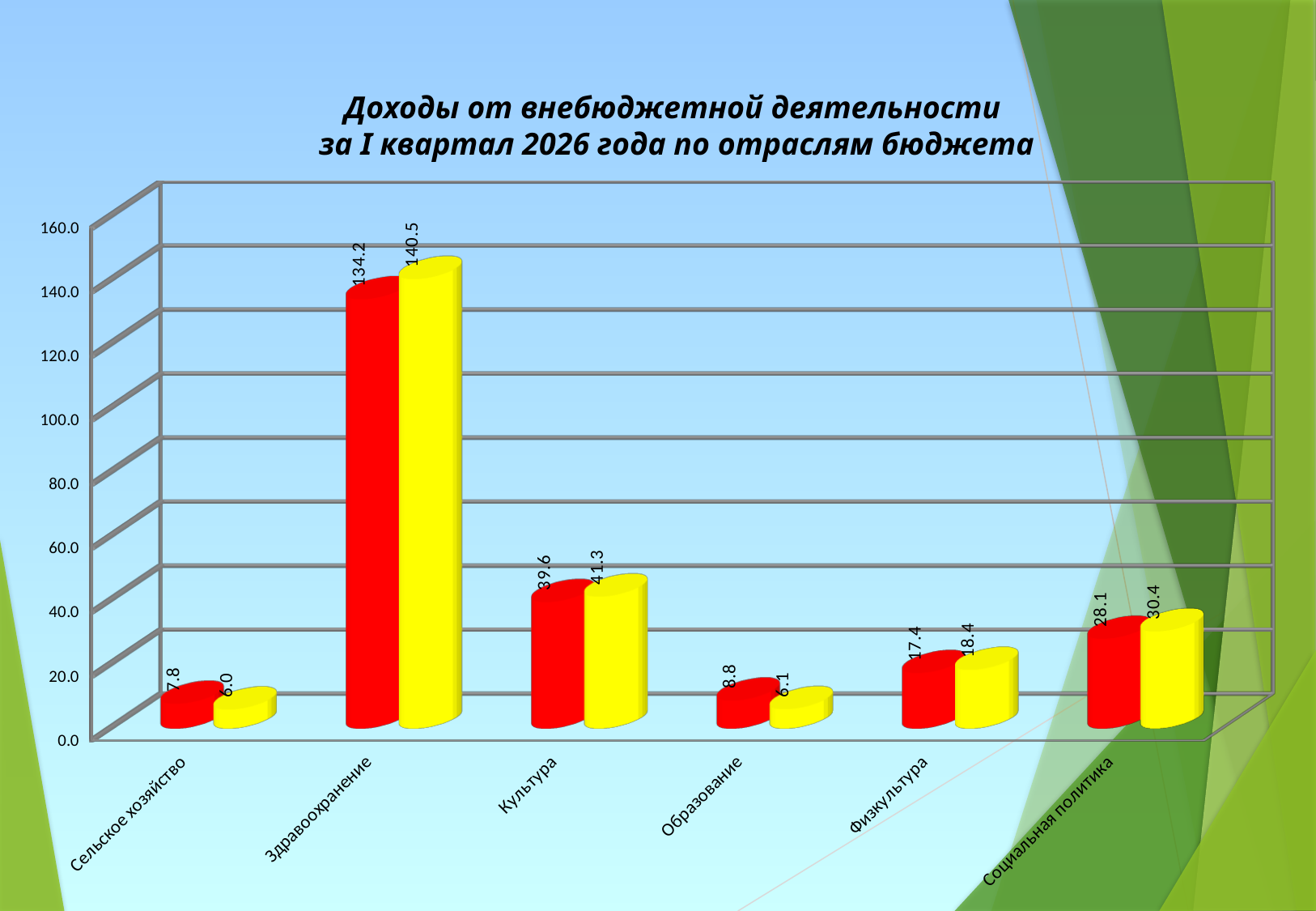
Which category has the highest red bar? Здравоохранение What is the value of the yellow bar for Здравоохранение? 140.5 What is the difference between the red and yellow bars for Образование? 2.7 How many categories are shown on the x axis? 6 What is the value of the red bar for Социальная политика? 28.1 Which category has the lowest yellow bar? Сельское хозяйство What is the value of the red bar for Здравоохранение? 134.2 What is the value of the yellow bar for Культура? 41.3 What kind of chart is shown on the slide? bar chart For Физкультура, which bar is larger, the red or the yellow? yellow What is the difference between the yellow and red bars for Здравоохранение? 6.3 What is the title of the chart? Доходы от внебюджетной деятельности за I квартал 2026 года по отраслям бюджета